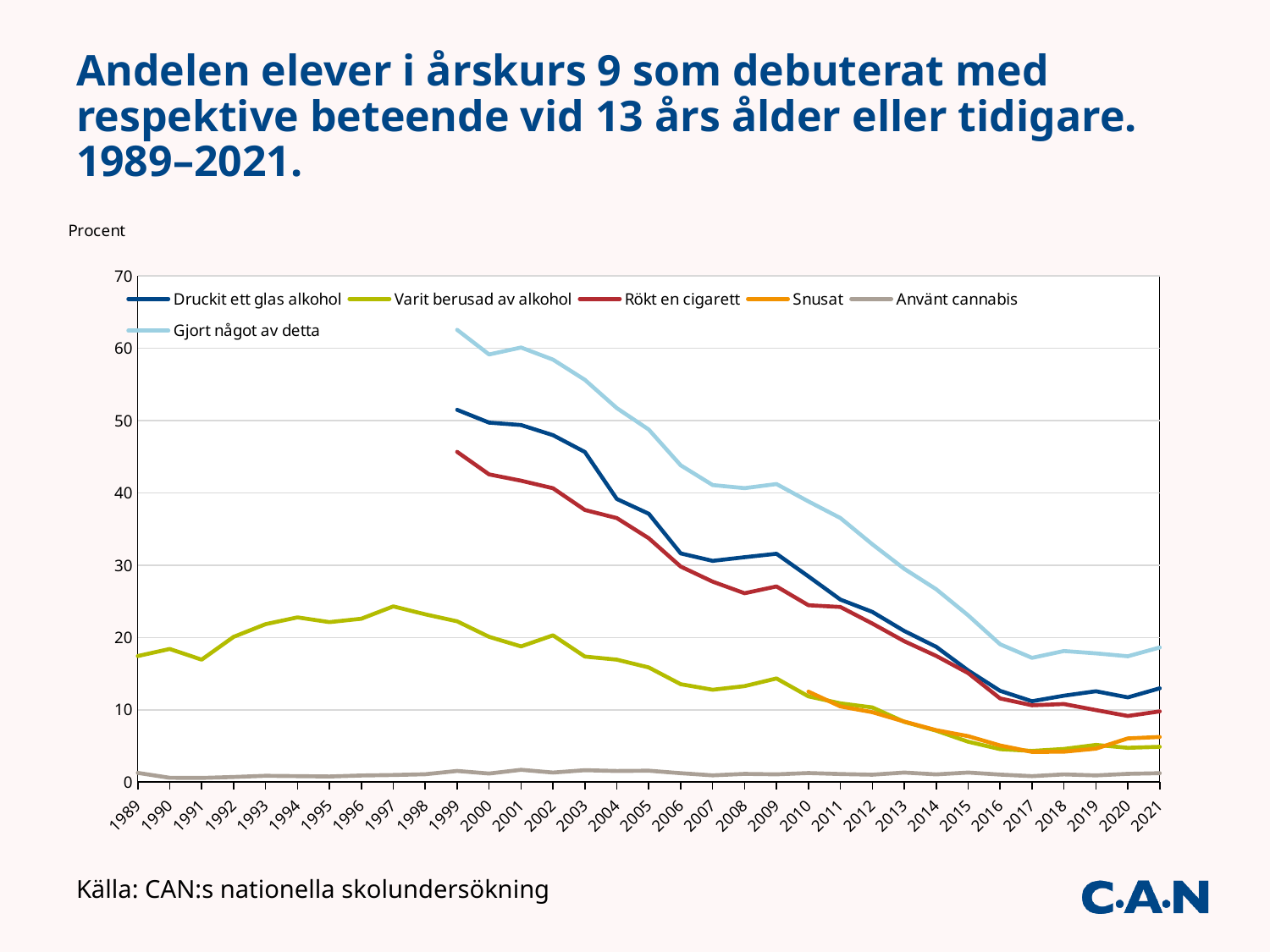
Which series has the highest value in 1999? Gjort något av detta Is the value for 'Gjort något av detta' in 1999 greater or less than 60? greater How many years are shown on the x axis? 33 What is the label on the y axis? Procent Does the value for 'Gjort något av detta' rise or fall from 1999 to 2021? Fall What kind of chart is shown on the slide? Line chart Which series has the lowest value in 2021? Använt cannabis Is the value for 'Varit berusad av alkohol' in 1997 greater or less than 20? greater Is the value for 'Druckit ett glas alkohol' in 1999 greater or less than 40? greater How many series does the legend list? 6 Does the value for 'Rökt en cigarett' rise or fall from 1999 to 2021? Fall